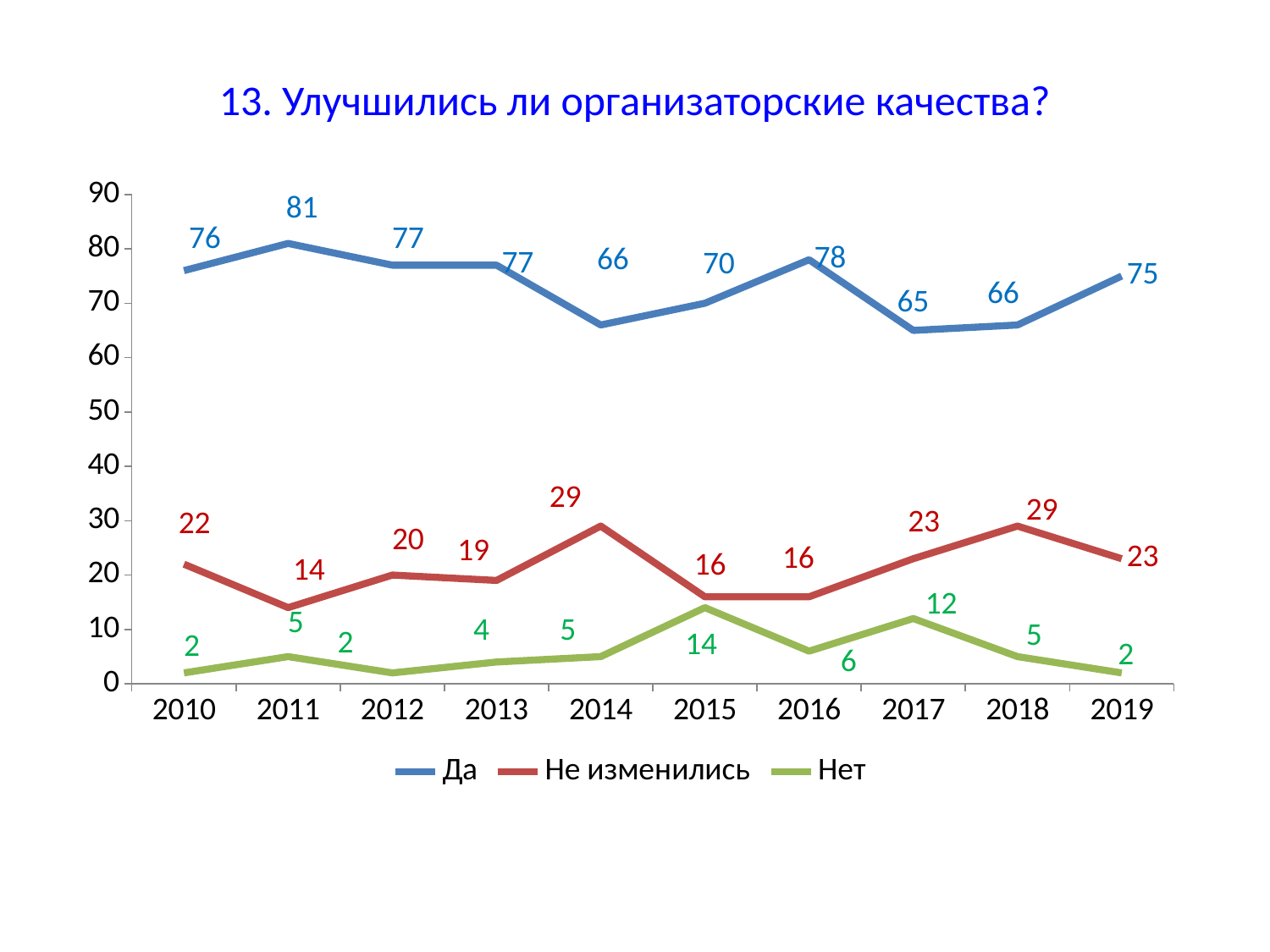
What is the value for "Нет" in 2015? 14 How many years are shown on the x axis? 10 In which year is the "Да" series at its lowest? 2017 What is the difference between the "Да" values in 2011 and 2017? 16 What kind of chart is shown on the slide? line chart In which year is the "Нет" series at its highest? 2015 What is the value for "Не изменились" in 2014? 29 What is the value for "Да" in 2011? 81 Which is larger: the "Не изменились" value in 2014 or in 2019? 2014 What is the title of the chart? 13. Улучшились ли организаторские качества? How many series does the legend list? 3 Does the "Да" series rise or fall from 2016 to 2017? fall